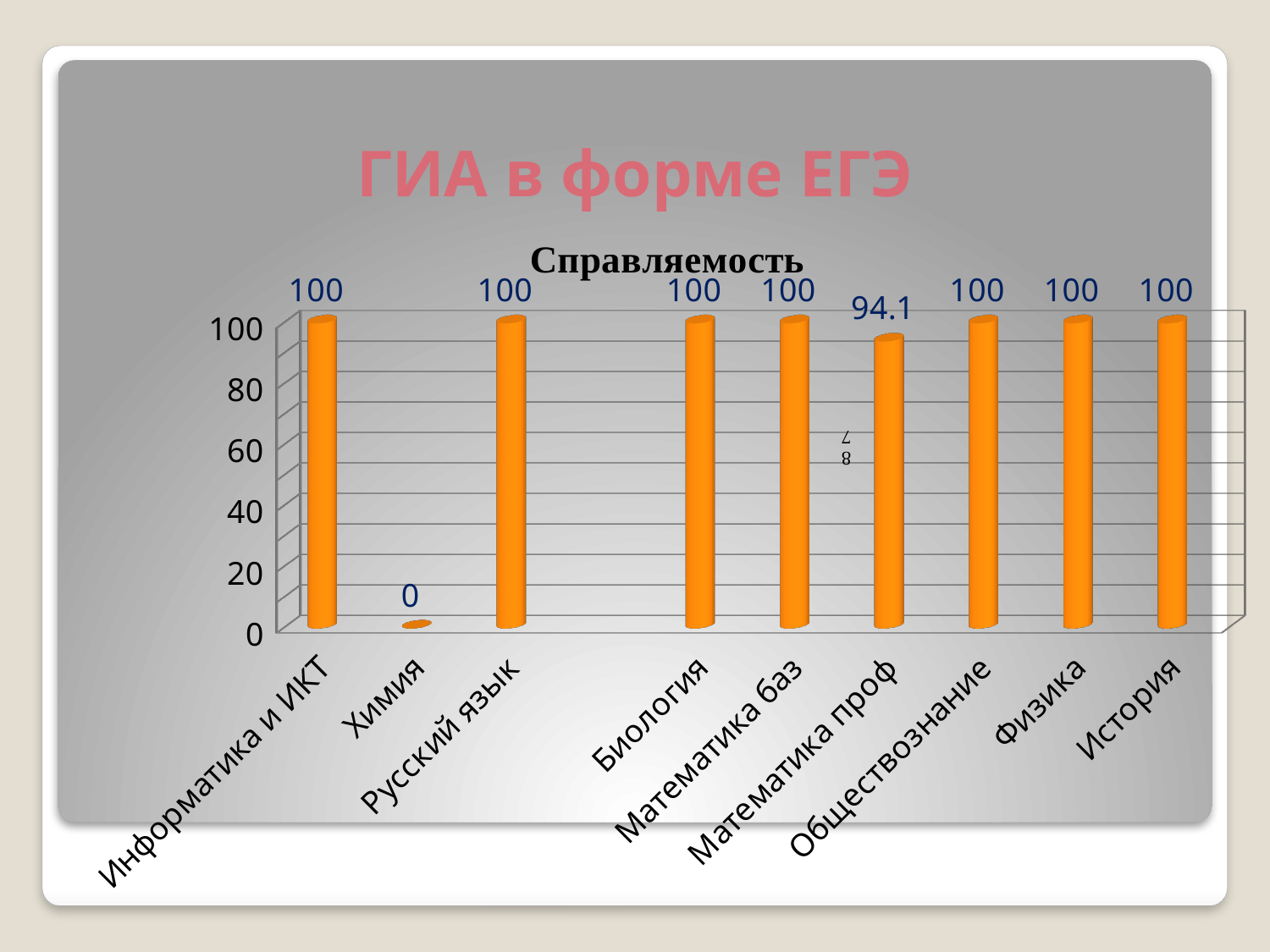
How many categories are shown on the x axis? 9 What is the value for Математика проф? 94.1 Which category has the lowest value? Химия What is the title of the chart? Справляемость Is the value for Математика проф greater or less than 80? greater Which is larger, the value for Биология or the value for Математика проф? Биология What kind of chart is shown on the slide? bar chart What is the difference between the values for Физика and Математика проф? 5.9 What is the value for Химия? 0 How many categories have a value of 100? 7 What is the value for Обществознание? 100 What is the value for Русский язык? 100